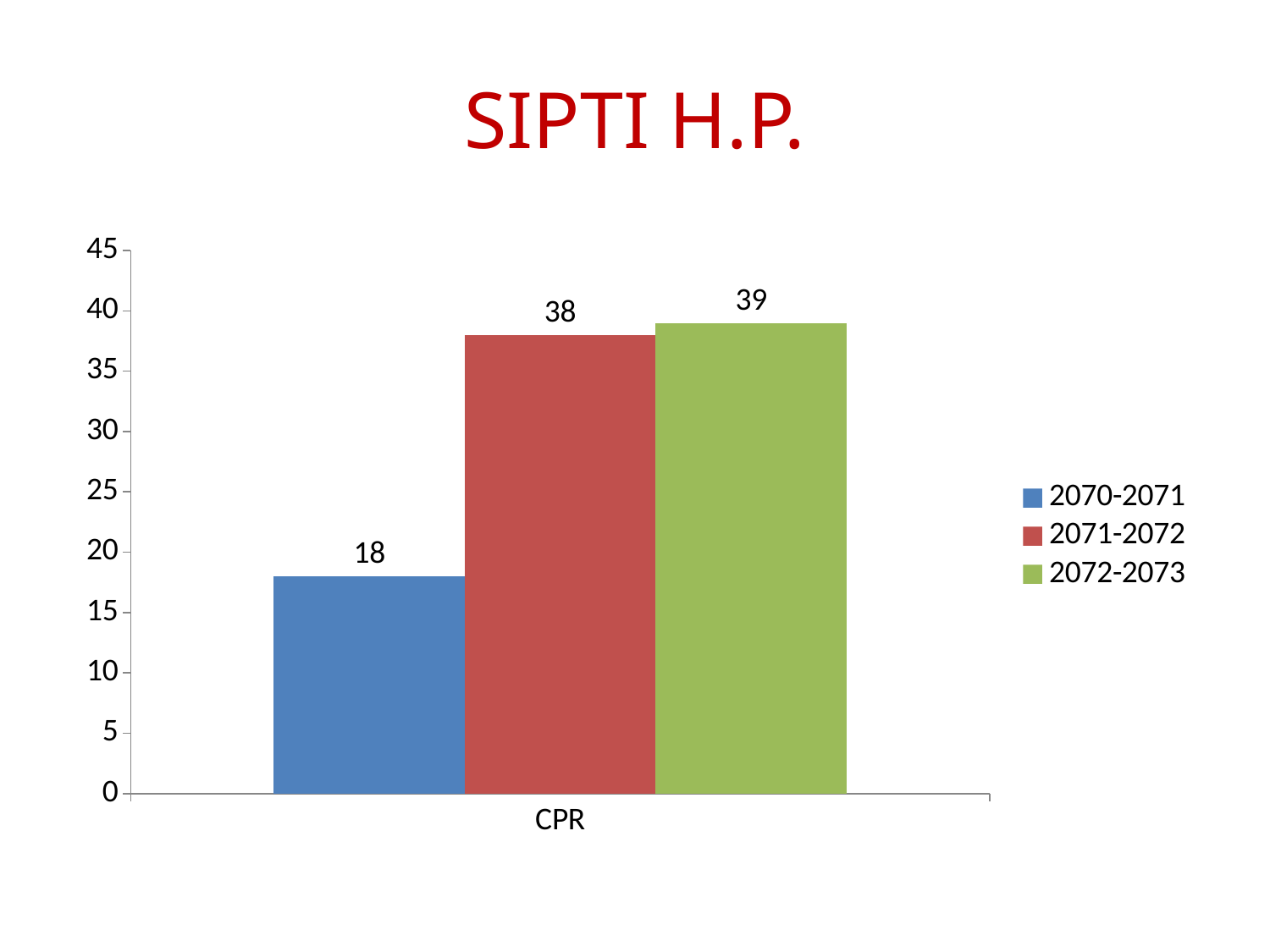
Which is larger, the CPR value for 2070-2071 or for 2071-2072? 2071-2072 What is the CPR value for 2070-2071? 18 What kind of chart is shown on the slide? bar chart Is the CPR value for 2070-2071 greater or less than 20? less What is the title of the slide? SIPTI H.P. How many series does the legend list? 3 What is the difference between the CPR values for 2072-2073 and 2071-2072? 1 Do the CPR values rise or fall from 2070-2071 to 2072-2073? rise What is the CPR value for 2072-2073? 39 What is the CPR value for 2071-2072? 38 What is the difference between the CPR values for 2071-2072 and 2070-2071? 20 Which series has the lowest CPR value? 2070-2071